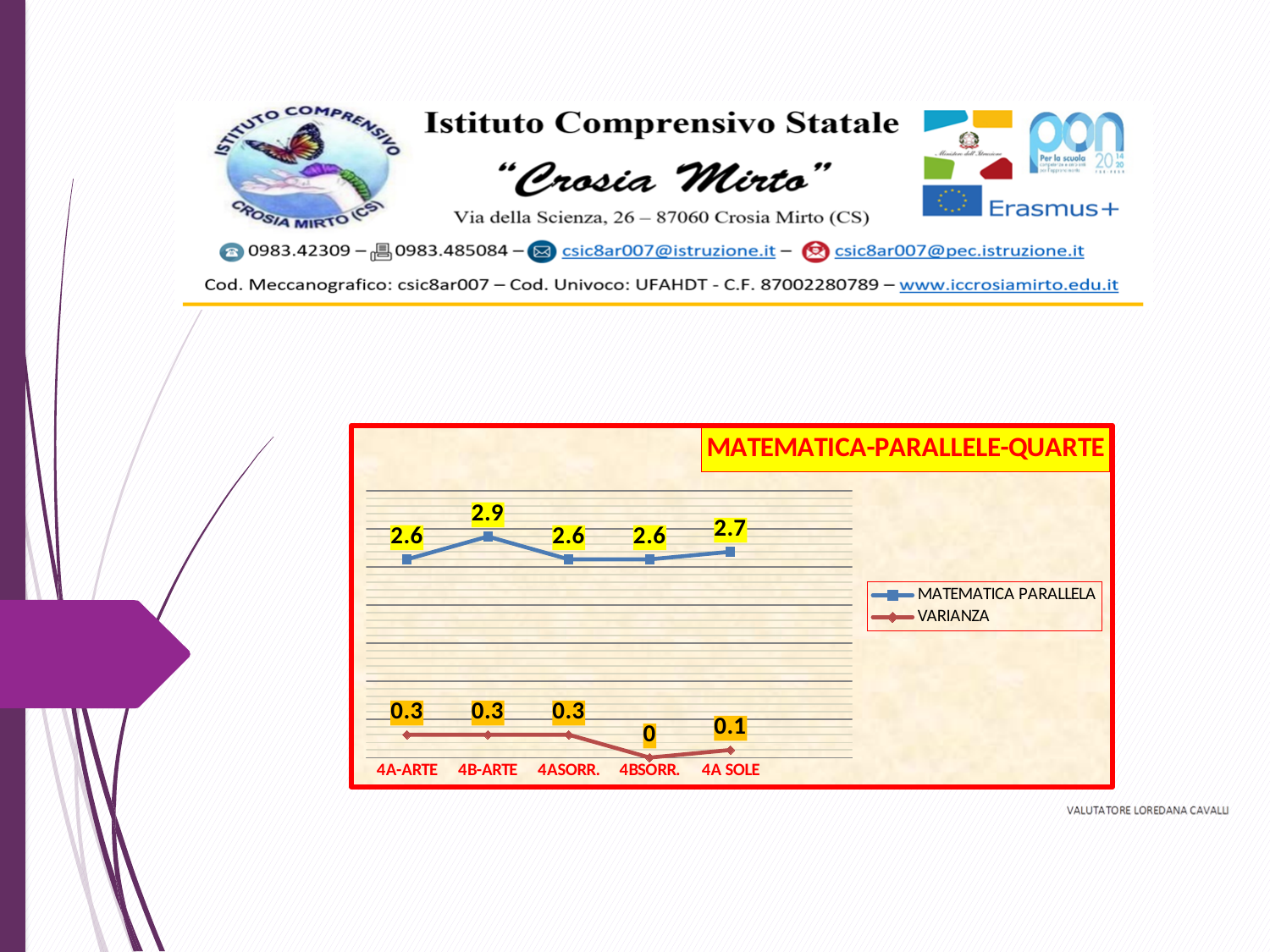
What is the VARIANZA value for 4A SOLE? 0.1 Which category has the lowest VARIANZA value? 4BSORR. How many series does the legend list? 2 What is the VARIANZA value for 4BSORR.? 0 What is the difference between the MATEMATICA PARALLELA values for 4B-ARTE and 4A-ARTE? 0.3 What is the MATEMATICA PARALLELA value for 4A SOLE? 2.7 How many categories are shown on the x axis? 5 What is the MATEMATICA PARALLELA value for 4B-ARTE? 2.9 What type of chart is shown on the slide? line chart Which category has the highest MATEMATICA PARALLELA value? 4B-ARTE What is the title of the chart? MATEMATICA-PARALLELE-QUARTE Which is larger, the MATEMATICA PARALLELA value for 4A SOLE or for 4BSORR.? 4A SOLE